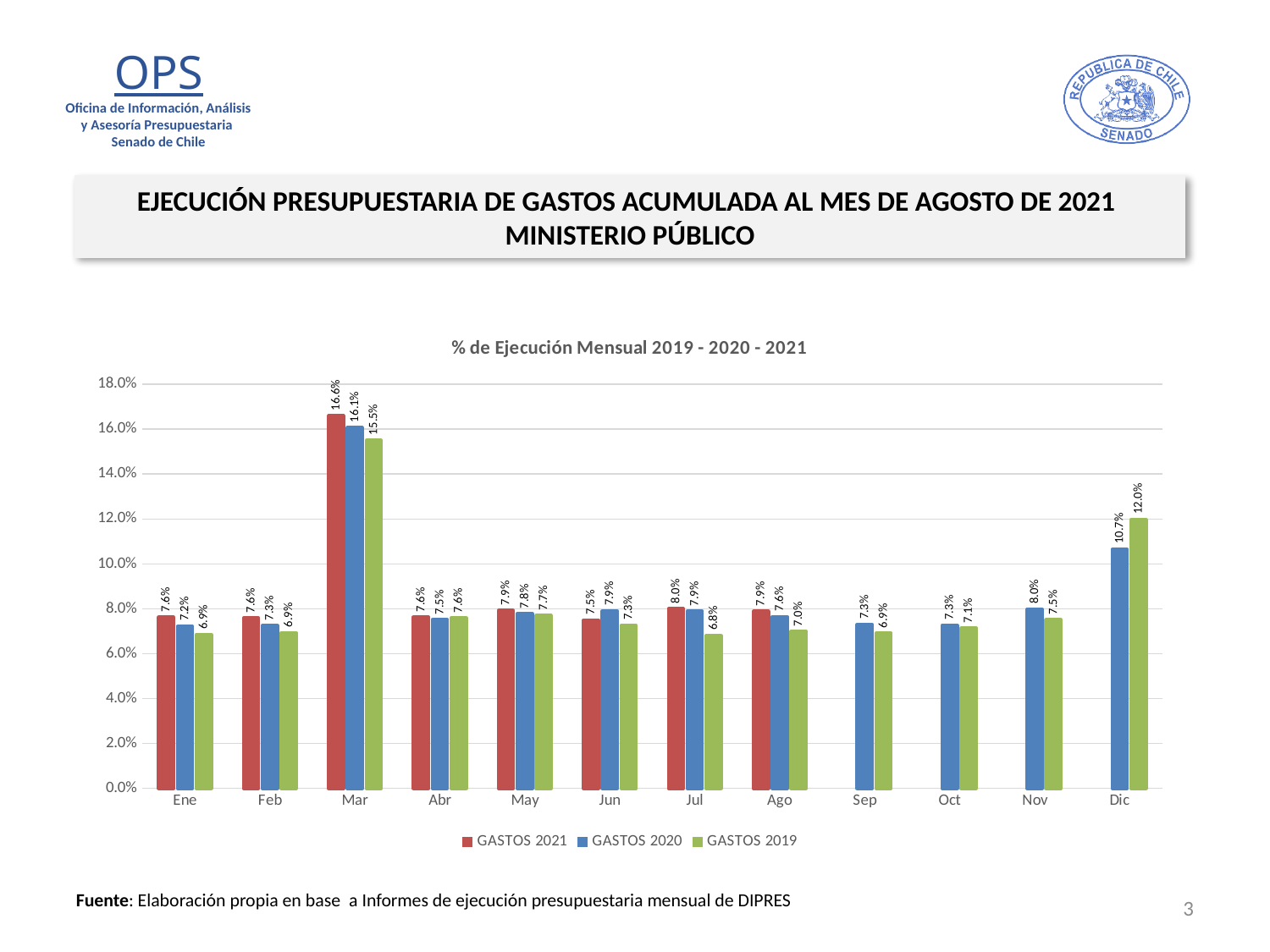
What is the value for GASTOS 2019 in Dic? 12.0% What is the title of the chart? % de Ejecución Mensual 2019 - 2020 - 2021 What is the value for GASTOS 2021 in Mar? 16.6% What kind of chart is shown on the slide? Bar chart Which is larger in Dic: GASTOS 2020 or GASTOS 2019? GASTOS 2019 Which month has the highest value for GASTOS 2020? Mar Which month has the lowest value for GASTOS 2019? Jul What is the value for GASTOS 2020 in Sep? 7.3% How many series does the legend list? 3 What is the value for GASTOS 2021 in Ago? 7.9% What is the difference between GASTOS 2021 and GASTOS 2019 in Mar? 1.1% How many months are shown on the x axis? 12